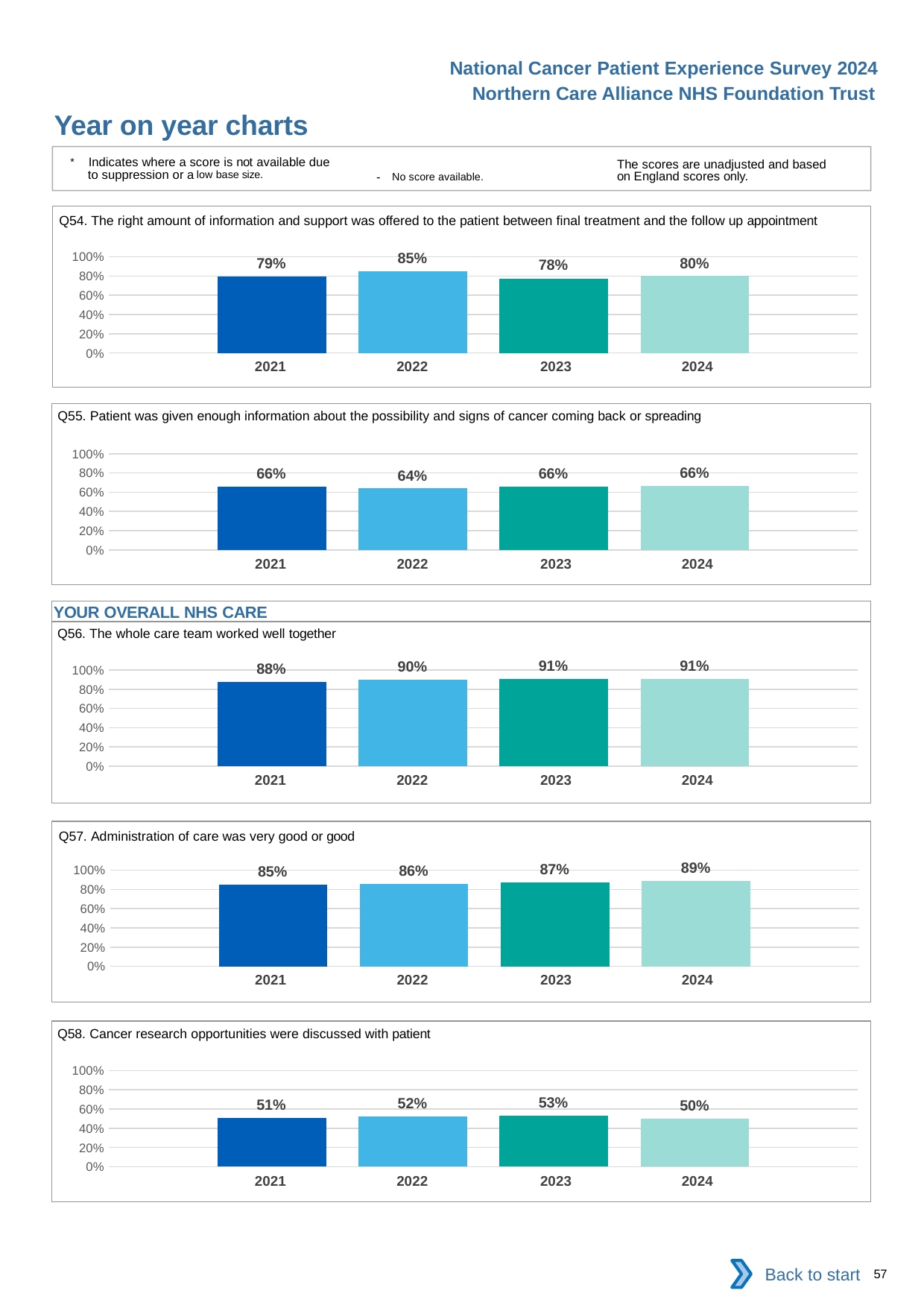
In the Q55 chart, what is the value for 2022? 64% In the Q58 chart, which year has the highest value? 2023 In the Q57 chart, do the values rise or fall from 2021 to 2024? rise In the Q58 chart, what is the difference between the 2023 and 2024 values? 3% In the Q54 chart, what is the value for 2022? 85% How many years are shown in the Q58 chart? 4 In the Q56 chart, what is the value for 2021? 88% In the Q54 chart, which year has the lowest value? 2023 In the Q56 chart, which is larger, the value for 2021 or the value for 2023? 2023 What type of chart is the Q54 chart? bar chart In the Q55 chart, what is the difference between the 2021 and 2022 values? 2% In the Q57 chart, what is the value for 2024? 89%